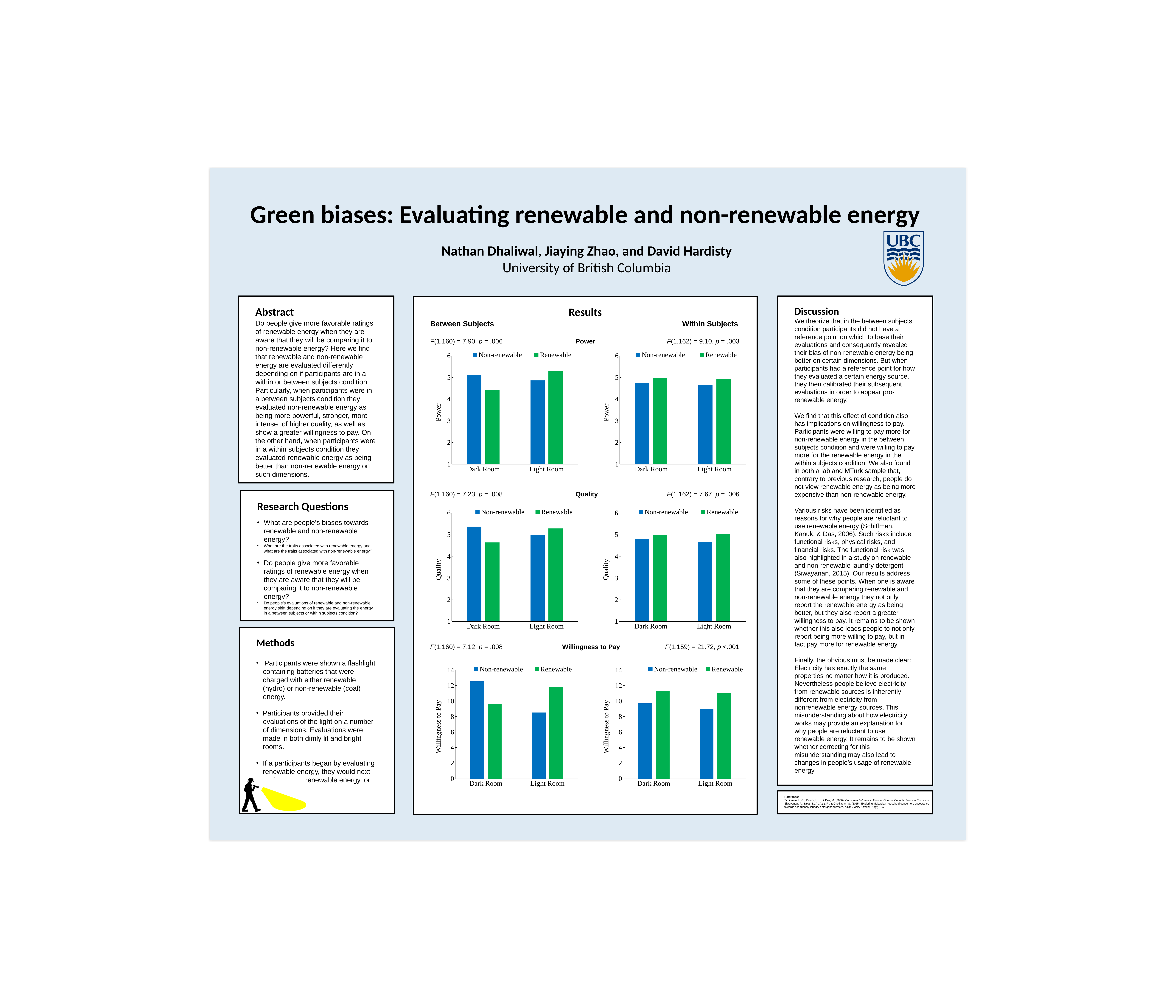
In the Between Subjects Willingness to Pay chart, which bar is the highest? Non-renewable, Dark Room What colour represents the Renewable series in the charts? green In the Between Subjects Quality chart, is the Renewable value for the Dark Room greater or less than 5? less In the Between Subjects Power chart, which is larger for the Dark Room: Non-renewable or Renewable? Non-renewable How many room categories are shown on the x axis of the Within Subjects Quality chart? 2 What kind of chart is the Between Subjects Power chart? bar chart In the Between Subjects Power chart, which is larger for the Light Room: Non-renewable or Renewable? Renewable In the Between Subjects Willingness to Pay chart, is the Non-renewable value for the Dark Room greater or less than 12? greater In the Between Subjects Willingness to Pay chart, is the Non-renewable value for the Light Room greater or less than 10? less In the Within Subjects Willingness to Pay chart, which is larger for the Dark Room: Non-renewable or Renewable? Renewable In the Between Subjects Quality chart, which bar is the lowest? Renewable, Dark Room How many series does the legend of the Between Subjects Power chart list? 2